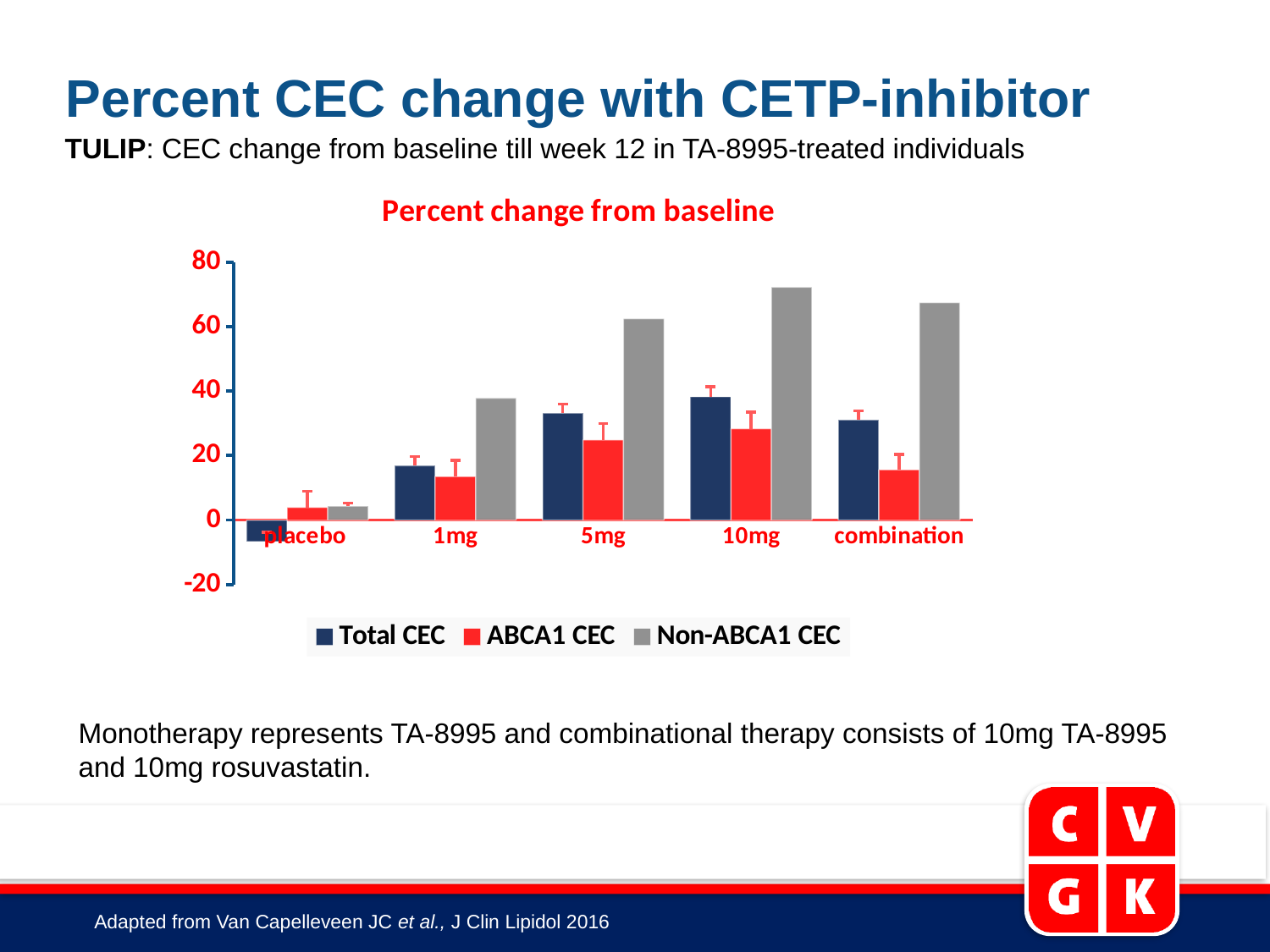
Is the Total CEC value for 1mg greater or less than 20? less Is the Non-ABCA1 CEC value for 10mg greater or less than 60? greater Is the Total CEC value for placebo greater or less than 0? less What kind of chart is shown on the slide? bar chart How many series does the chart legend list? 3 Do the Non-ABCA1 CEC values rise or fall from placebo to 10mg? rise How many categories are shown on the x axis of the chart? 5 Which category has the lowest Total CEC value? placebo Which is larger for the 5mg group: Total CEC or ABCA1 CEC? Total CEC Which category has the highest Non-ABCA1 CEC value? 10mg What is the title of the chart? Percent change from baseline